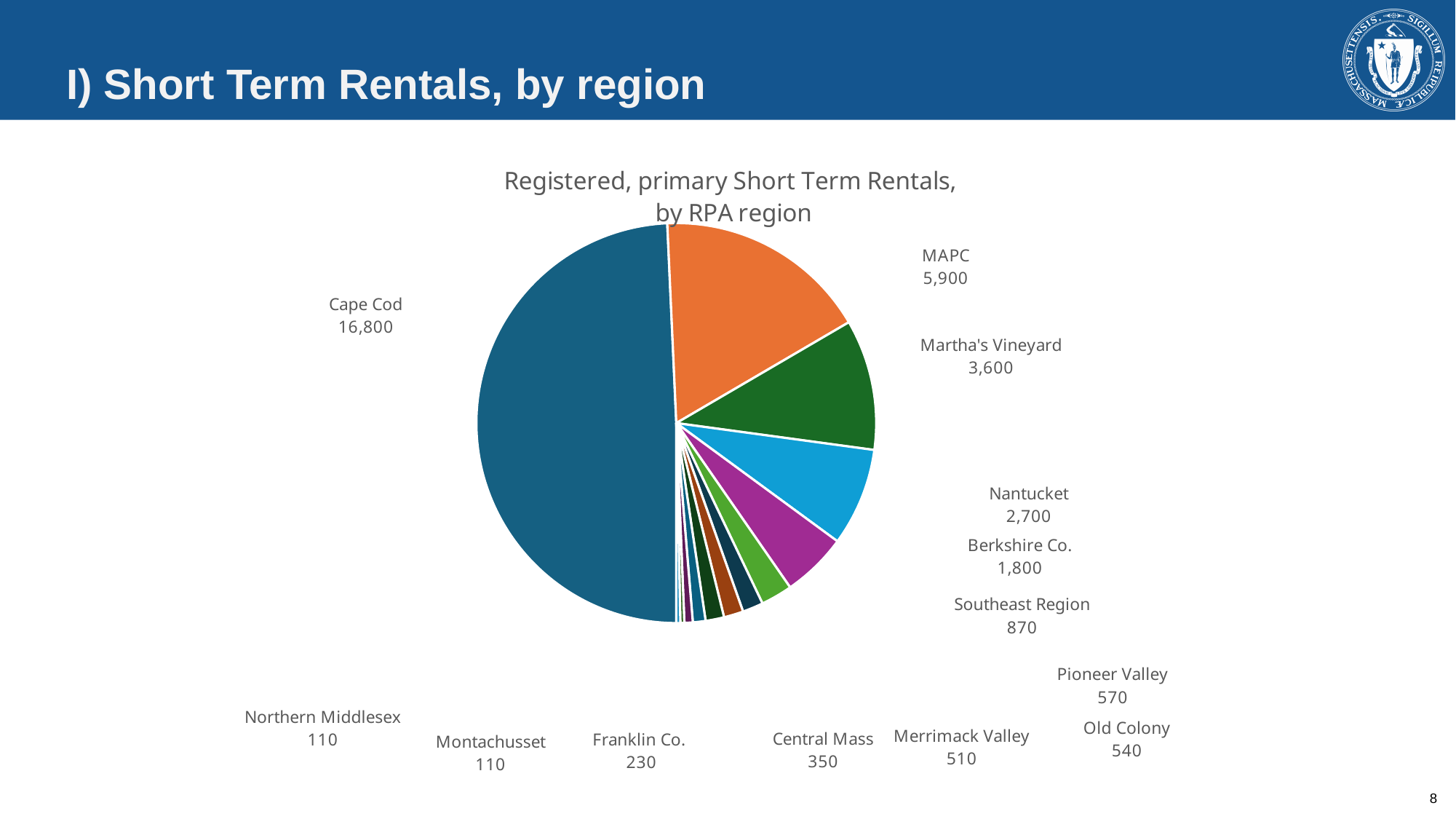
What is the difference between the values for Cape Cod and MAPC? 10,900 What is the difference between the values for MAPC and Martha's Vineyard? 2,300 What is the smallest value shown on the pie chart? 110 What is the title of the chart? Registered, primary Short Term Rentals, by RPA region What kind of chart is shown on the slide? Pie chart Which region has the largest slice of the pie chart? Cape Cod What is the value for Cape Cod in the pie chart? 16,800 How many regions are shown in the pie chart? 13 How many registered primary short term rentals are shown for MAPC? 5,900 What is the value shown for Franklin Co.? 230 What is the value shown for Nantucket? 2,700 Which is larger, the value for Pioneer Valley or the value for Old Colony? Pioneer Valley